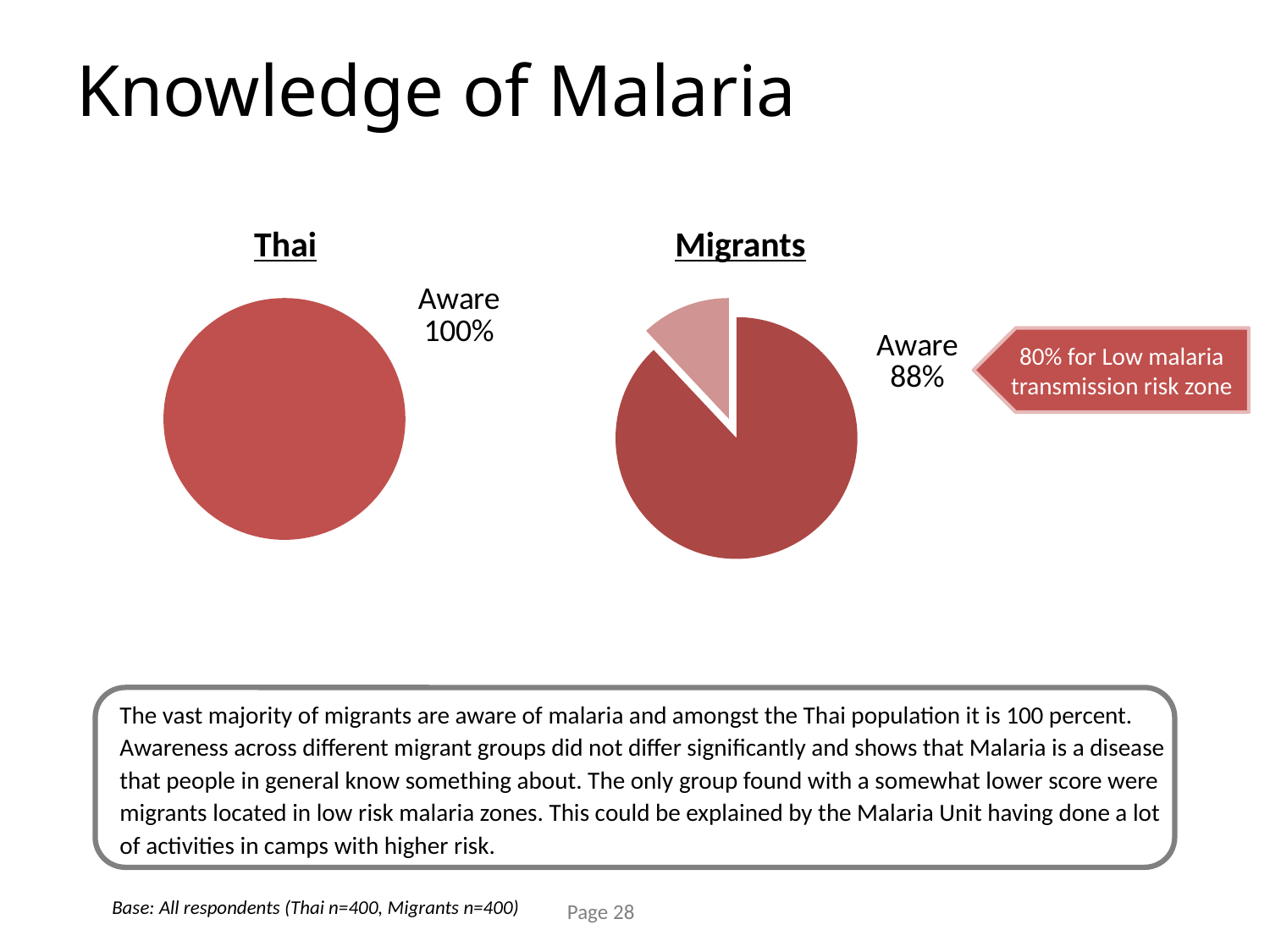
According to the callout next to the Migrants pie chart, what is the awareness share for the low malaria transmission risk zone? 80% What kind of chart is used to show awareness for the Thai group? Pie chart How many slices does the Thai pie chart have? 1 What kind of chart is used to show awareness for the Migrants group? Pie chart In the Thai pie chart, what share of respondents are aware of malaria? 100% How many pie charts are shown on the slide? 2 In the Migrants pie chart, is the aware slice larger or smaller than the other slice? Larger Which group has the higher share of respondents aware of malaria, Thai or Migrants? Thai What is the title of the slide containing the two pie charts? Knowledge of Malaria In the Migrants pie chart, what share of respondents are aware of malaria? 88% How many slices does the Migrants pie chart have? 2 What is the difference in the aware share between the Thai chart and the Migrants chart? 12%